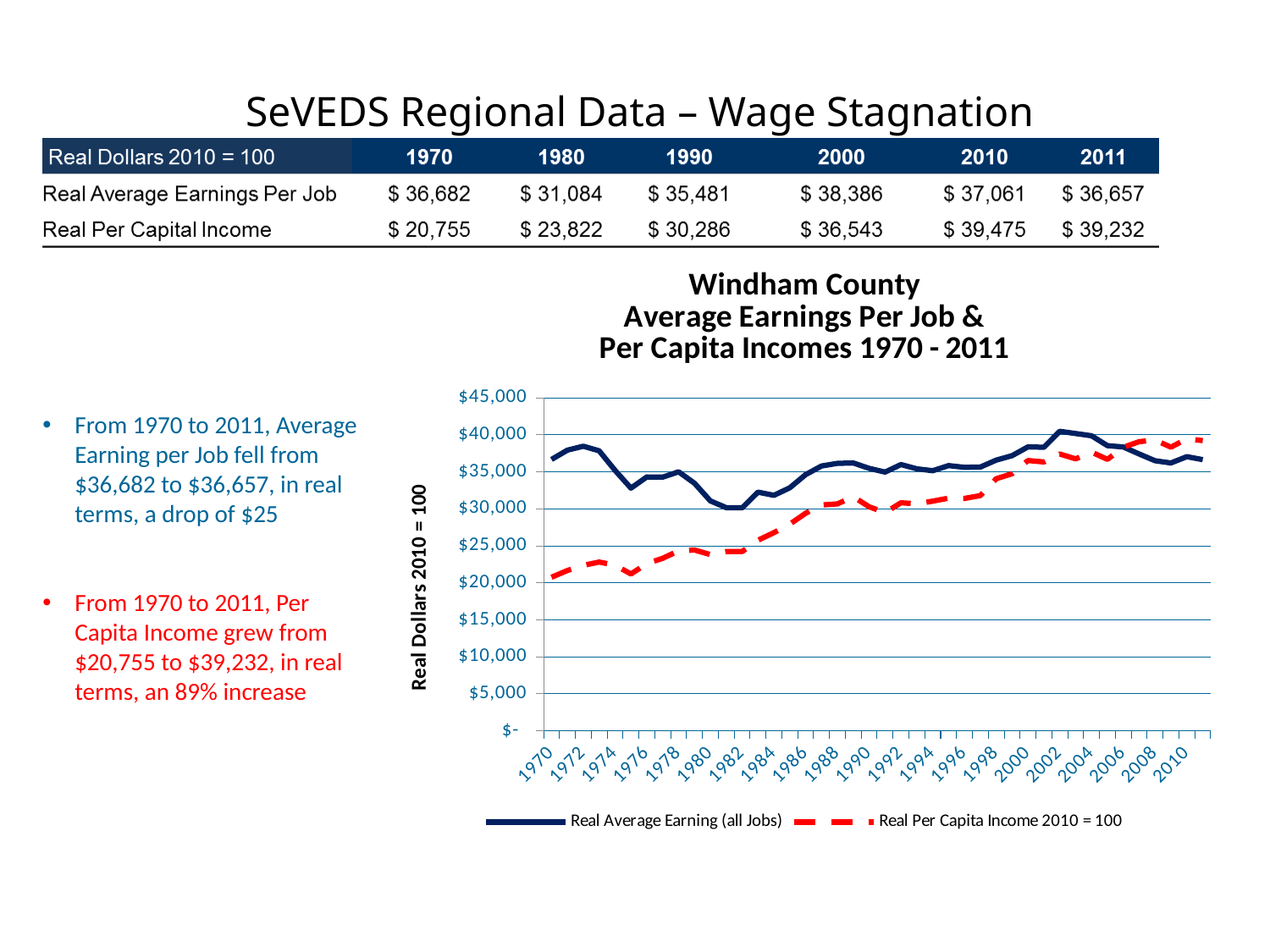
In 1970, which series is higher on the chart: Real Average Earning (all Jobs) or Real Per Capita Income? Real Average Earning (all Jobs) What is the title of the chart's vertical axis? Real Dollars 2010 = 100 In 2010, which series is higher on the chart: Real Average Earning (all Jobs) or Real Per Capita Income? Real Per Capita Income Is the value for Real Average Earning (all Jobs) in 1982 greater or less than $35,000? less According to the slide, what was Real Average Earnings Per Job in 1970? $ 36,682 According to the values printed on the slide, how much higher was Real Per Capita Income than Real Average Earnings Per Job in 2011? $2,575 What kind of chart is shown on the slide? line chart Is the value for Real Per Capita Income in 2008 greater or less than $35,000? greater What are the two series named in the chart's legend? Real Average Earning (all Jobs) and Real Per Capita Income 2010 = 100 Is the value for Real Per Capita Income in 1970 greater or less than $25,000? less Does the Real Per Capita Income line generally rise or fall from 1970 to 2010? rise How many series does the chart's legend list? 2